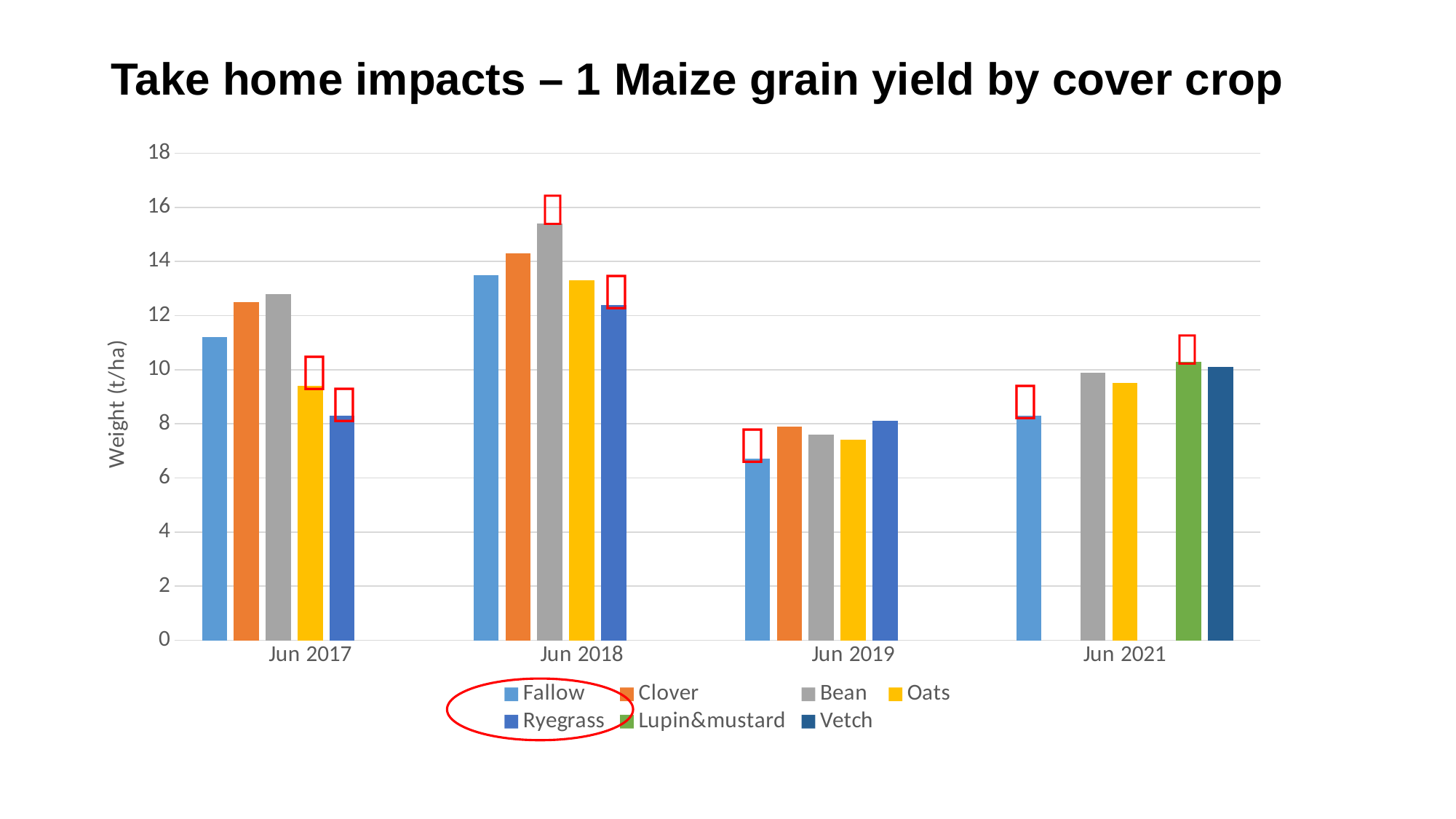
How many date categories are shown on the x axis? 4 In Jun 2017, which is larger: the value for Clover or the value for Fallow? Clover Which cover crop has the lowest maize grain yield in Jun 2017? Ryegrass Is the value for Bean in Jun 2018 greater or less than 14? greater What is the label on the y axis? Weight (t/ha) Is the value for Fallow in Jun 2019 greater or less than 8? less Which legend entry is circled in red? Fallow Which cover crop has the highest maize grain yield in Jun 2018? Bean Does the value for Fallow rise or fall from Jun 2018 to Jun 2019? fall What kind of chart is shown on the slide? bar chart Is the value for Oats in Jun 2017 greater or less than 10? less How many series does the legend list? 7